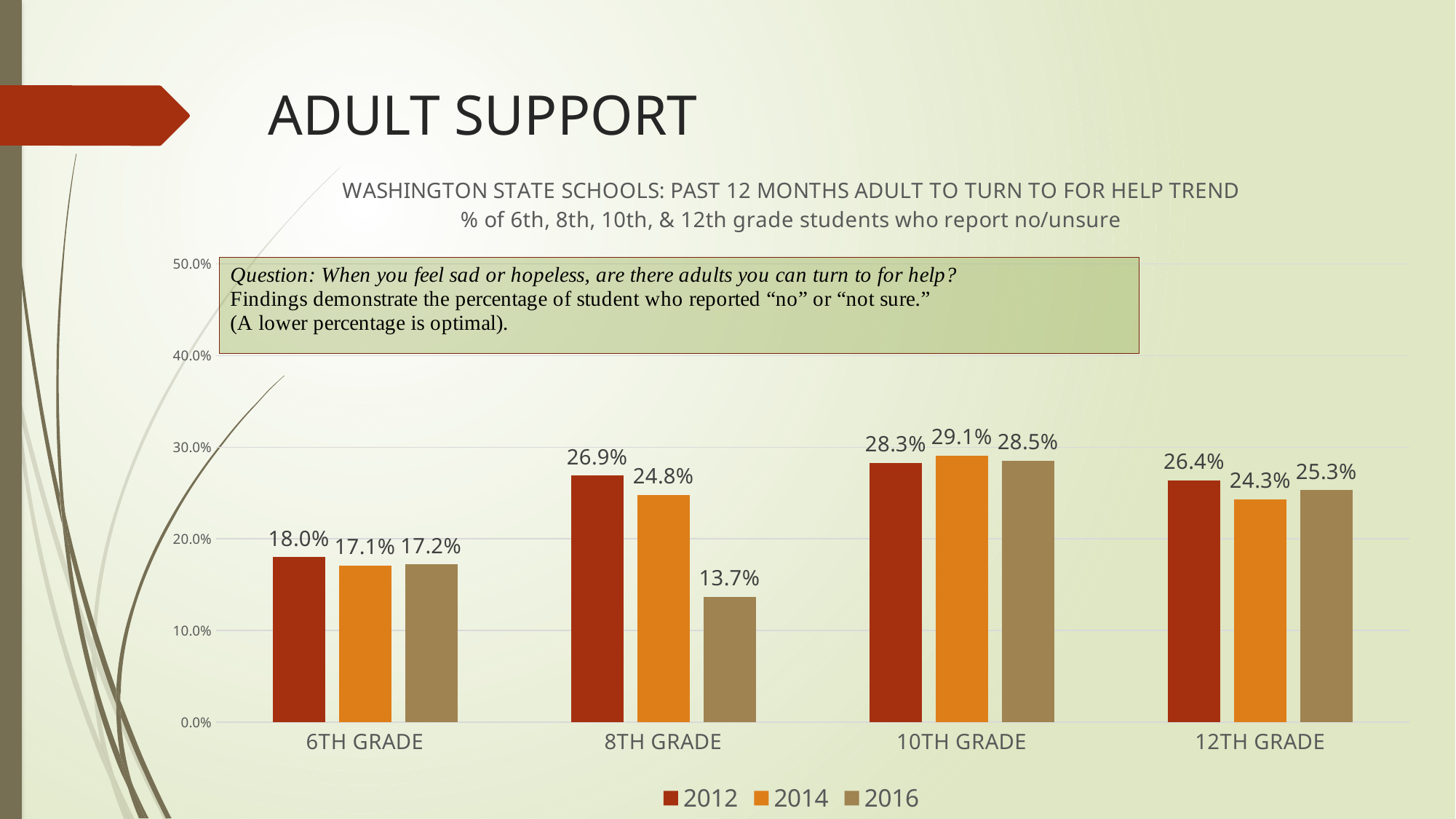
What is the value for 8th grade in 2016? 13.7% What is the value for 6th grade in 2014? 17.1% Which grade has the lowest value in 2016? 8th grade Which years are listed in the legend? 2012, 2014, 2016 How many grade categories are shown on the x axis? 4 What is the difference between the 2012 and 2016 values for 8th grade? 13.2% Which grade has the highest value in 2014? 10th grade Is the value for 10th grade in 2014 greater or less than 20.0%? greater What is the value for 12th grade in 2012? 26.4% What kind of chart is shown on the slide? bar chart Which is larger for 12th grade: the 2014 value or the 2016 value? 2016 How many series does the legend list? 3